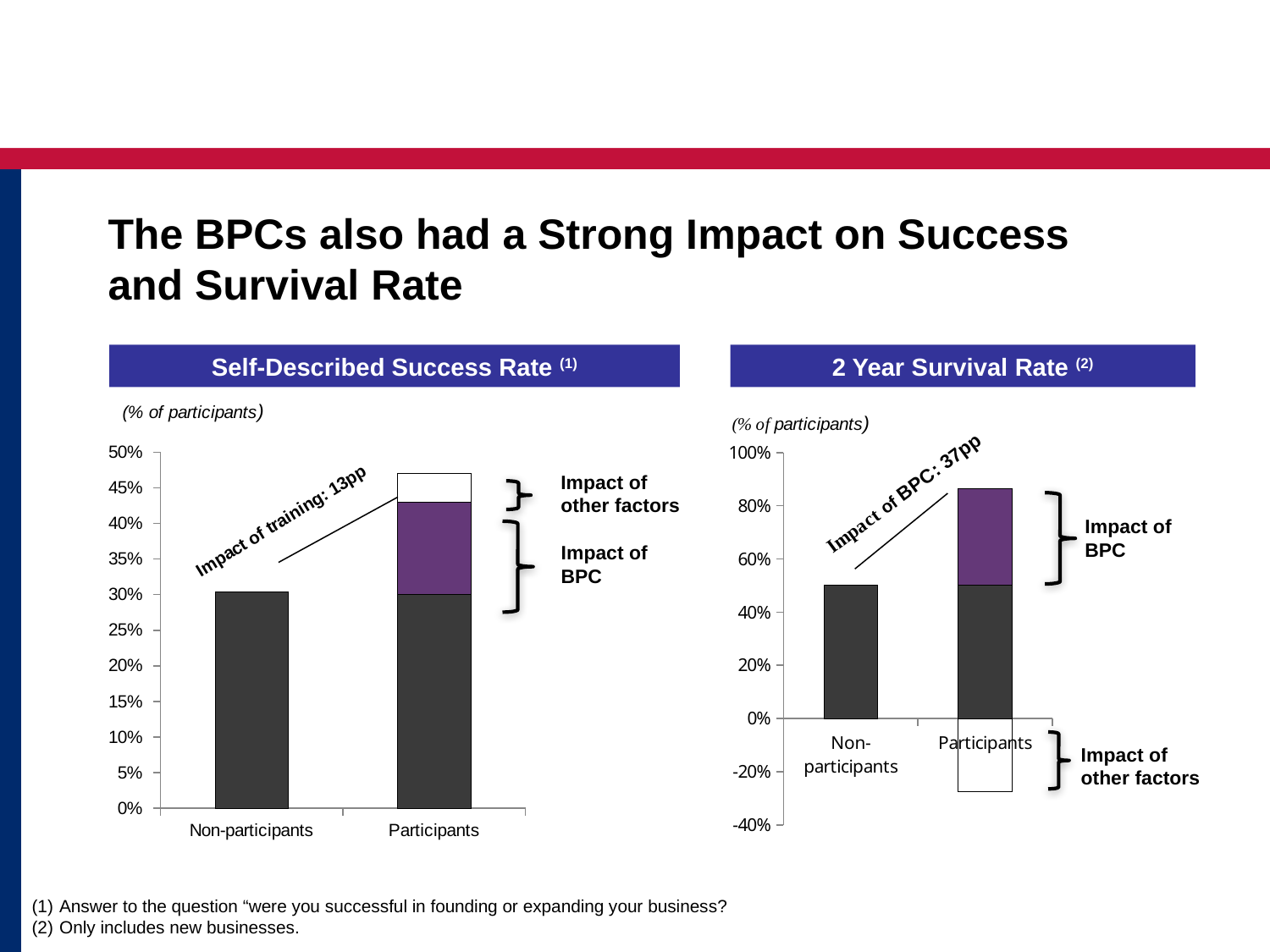
In the 2 Year Survival Rate chart, what is the impact of BPC shown in the annotation? 37pp In the Self-Described Success Rate chart, is the value for Non-participants greater or less than 35%? less In the Self-Described Success Rate chart, is the value for Non-participants greater or less than 25%? greater In the 2 Year Survival Rate chart, does the top of the Participants bar reach greater or less than 80%? greater What unit is stated in italics below the title of the Self-Described Success Rate chart? % of participants In the Self-Described Success Rate chart, what is the impact of training shown in the annotation? 13pp In the 2 Year Survival Rate chart, what is the lowest value shown on the y axis? -40% In the Self-Described Success Rate chart, which category has the taller bar, Non-participants or Participants? Participants How many categories are shown on the x axis of the 2 Year Survival Rate chart? 2 What kind of chart is the Self-Described Success Rate chart? Bar chart How many categories are shown on the x axis of the Self-Described Success Rate chart? 2